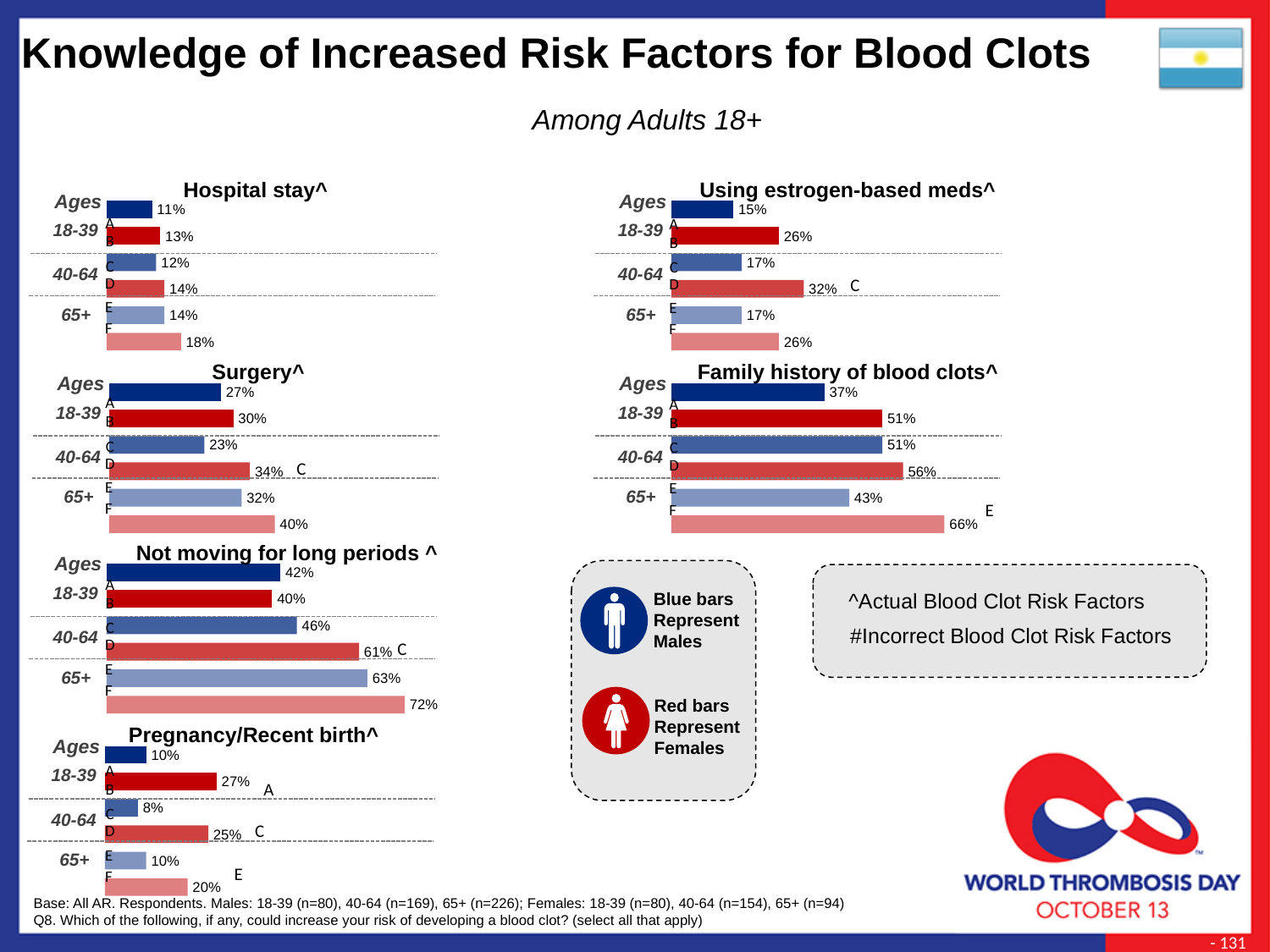
According to the legend on the slide, what do the red bars represent? Females In the 'Not moving for long periods' chart, which bar has the highest value? Females 65+ (72%) In the 'Family history of blood clots' chart, what percentage of males aged 18-39 is shown? 37% How many separate risk-factor charts are shown on the slide? 6 In the 'Surgery' chart, what percentage of males aged 40-64 is shown? 23% In the 'Not moving for long periods' chart, what is the difference between females 40-64 and males 40-64? 15 percentage points How many bars does the 'Surgery' chart contain? 6 What type of chart is used for 'Family history of blood clots'? Bar chart In the 'Family history of blood clots' chart, what is the difference between females 65+ and males 65+? 23 percentage points In the 'Pregnancy/Recent birth' chart, which bar has the lowest value? Males 40-64 (8%) In the 'Using estrogen-based meds' chart, which is larger: females 40-64 or females 18-39? Females 40-64 (32%) In the 'Hospital stay' chart, what percentage of females aged 65+ is shown? 18%